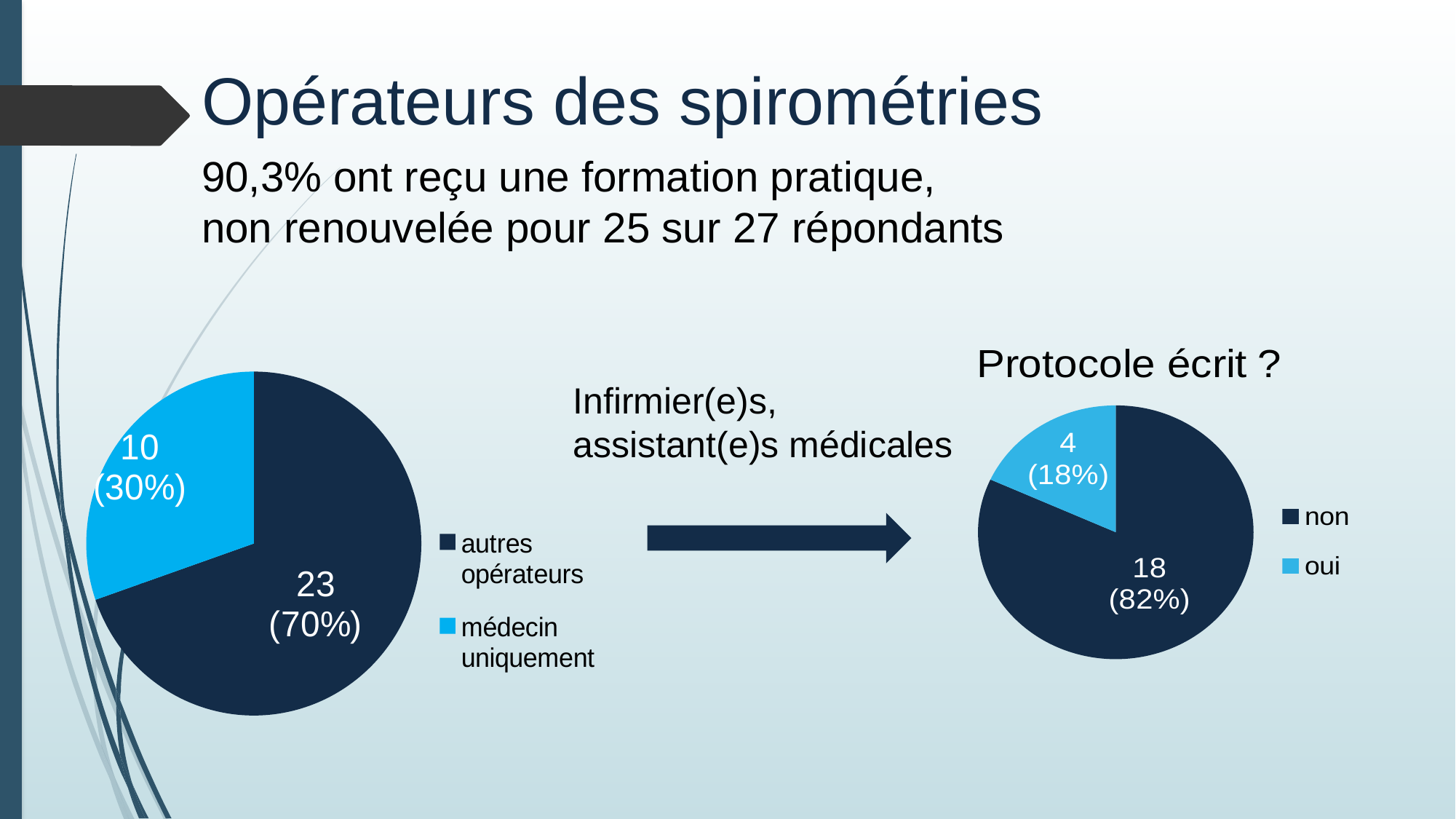
In the 'Protocole écrit ?' chart, what is the value for 'oui'? 4 (18%) In the left pie chart, what is the value for 'autres opérateurs'? 23 (70%) In the left pie chart, what is the difference between 'autres opérateurs' and 'médecin uniquement'? 13 In the 'Protocole écrit ?' chart, which category is the smallest? oui How many categories does the legend of the left pie chart list? 2 In the 'Protocole écrit ?' chart, what is the value for 'non'? 18 (82%) In the left pie chart, what share of the pie does 'médecin uniquement' represent? 30% In the left pie chart, which category is the largest? autres opérateurs In the 'Protocole écrit ?' chart, what is the difference between 'non' and 'oui'? 14 In the left pie chart, what is the value for 'médecin uniquement'? 10 (30%) In the 'Protocole écrit ?' chart, what share of the pie does 'oui' represent? 18% What kind of chart is the 'Protocole écrit ?' chart? pie chart